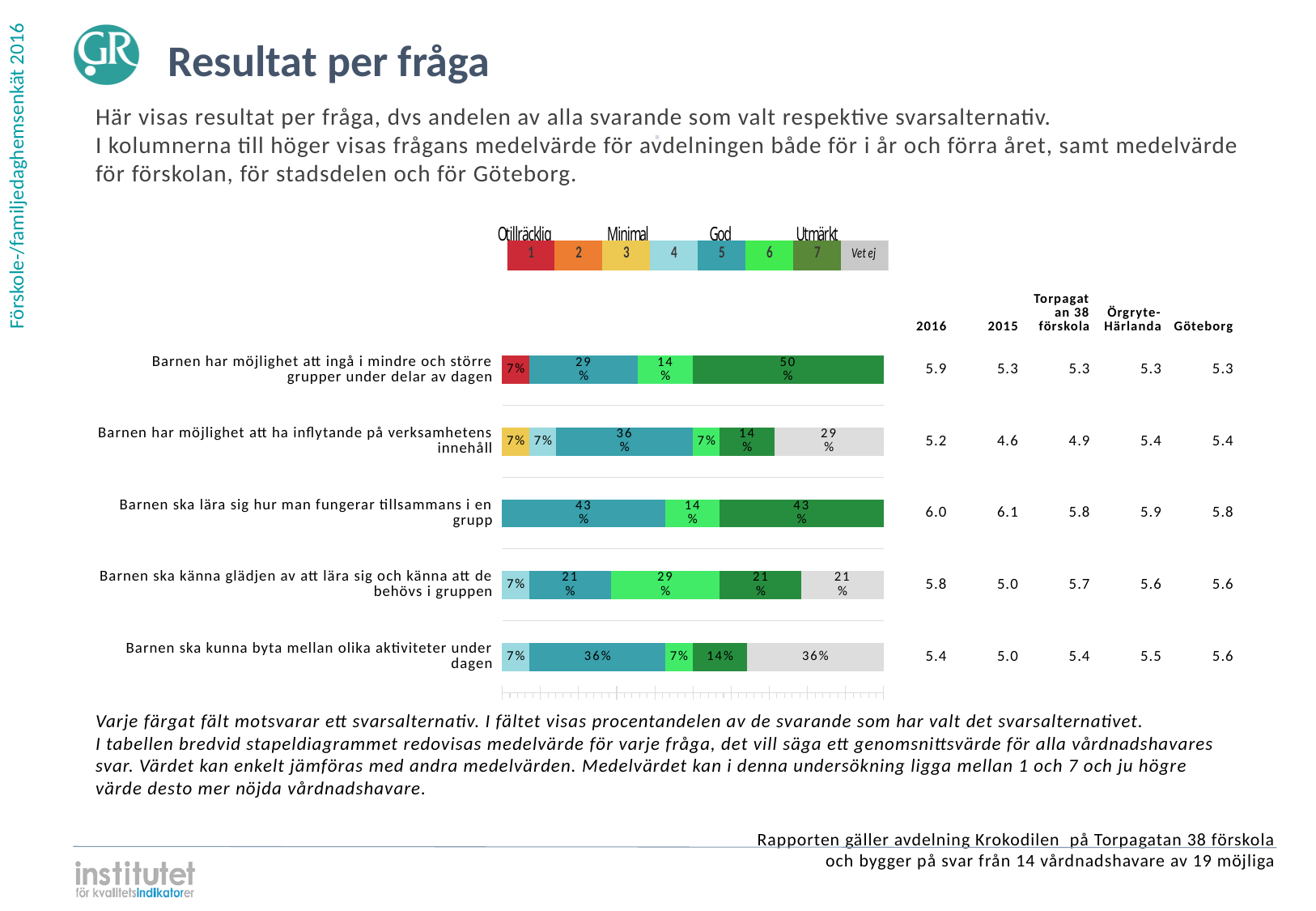
What is the difference between the share choosing answer 7 and the share choosing answer 6 for 'Barnen har möjlighet att ingå i mindre och större grupper under delar av dagen'? 36% What percentage of respondents chose answer 7 (Utmärkt) for 'Barnen har möjlighet att ingå i mindre och större grupper under delar av dagen'? 50% What is the 2015 mean value for 'Barnen har möjlighet att ha inflytande på verksamhetens innehåll'? 4.6 What is the total of the segments in the bar for 'Barnen ska lära sig hur man fungerar tillsammans i en grupp'? 100% What kind of chart is shown on the slide? Stacked bar chart What percentage chose 'Vet ej' for 'Barnen ska kunna byta mellan olika aktiviteter under dagen'? 36% For 'Barnen ska känna glädjen av att lära sig och känna att de behövs i gruppen', which is larger: the share choosing answer 6 or the share choosing answer 7? Answer 6 (29%) Which question has the largest share of respondents choosing answer 7 (Utmärkt)? Barnen har möjlighet att ingå i mindre och större grupper under delar av dagen What percentage chose answer 5 for 'Barnen ska lära sig hur man fungerar tillsammans i en grupp'? 43% What is the 2016 mean value for 'Barnen ska lära sig hur man fungerar tillsammans i en grupp'? 6.0 How many questions (bars) are shown in the chart? 5 Which answer category in the legend is shown in red? 1 (Otillräcklig)